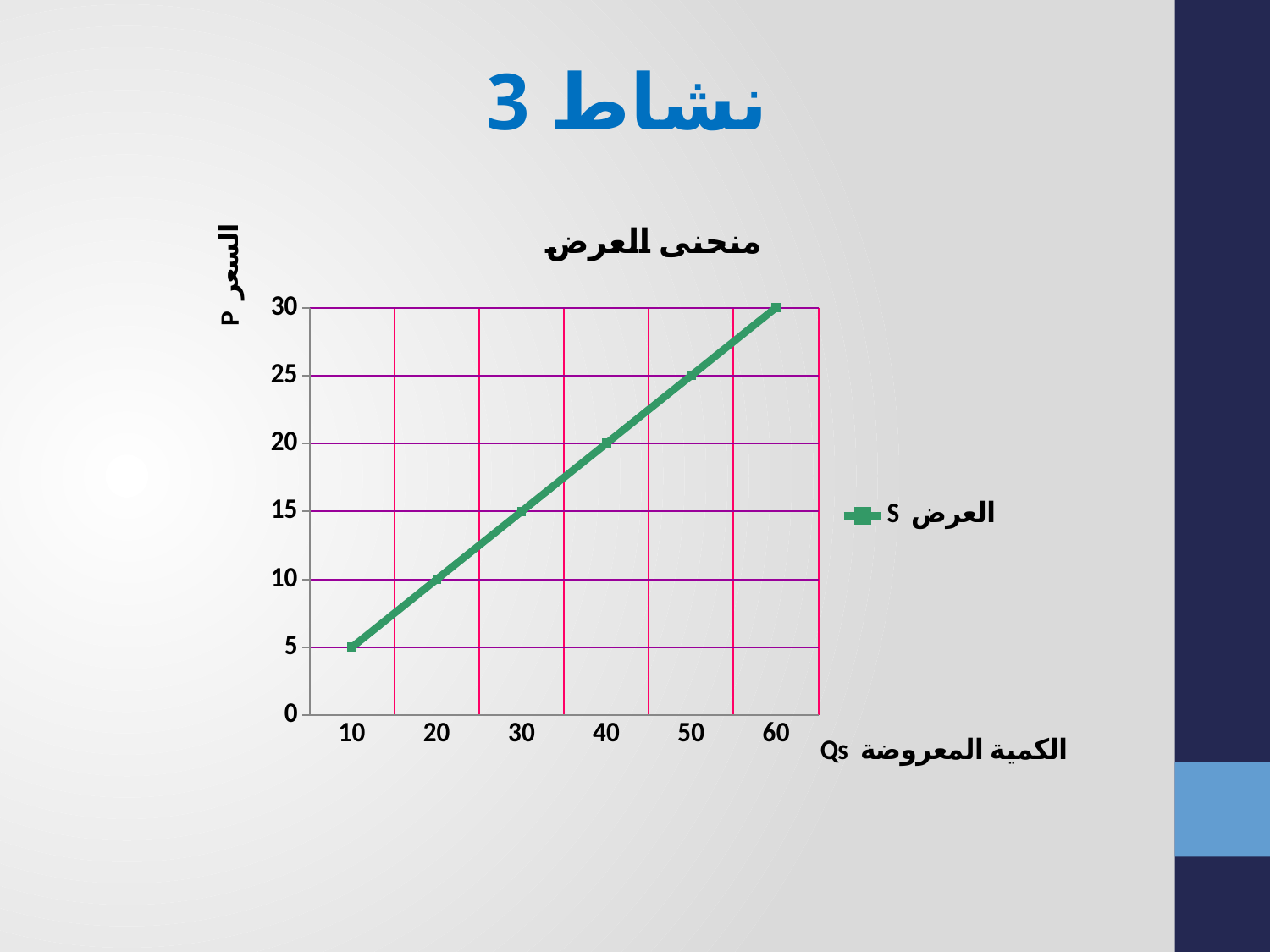
What is the price (P) when the quantity supplied (Qs) is 60? 30 What is the price (P) when the quantity supplied (Qs) is 40? 20 At which quantity supplied (Qs) is the price highest? 60 Does the price rise or fall as the quantity supplied increases along the x axis? rise What is the price (P) when the quantity supplied (Qs) is 10? 5 At which quantity supplied (Qs) is the price lowest? 10 How many series does the legend list? 1 What is the difference in price between Qs = 50 and Qs = 20? 15 How many data points are plotted on the line? 6 What is the title of the chart? منحنى العرض What kind of chart is shown on the slide? line chart What is the name of the series in the legend? العرض S